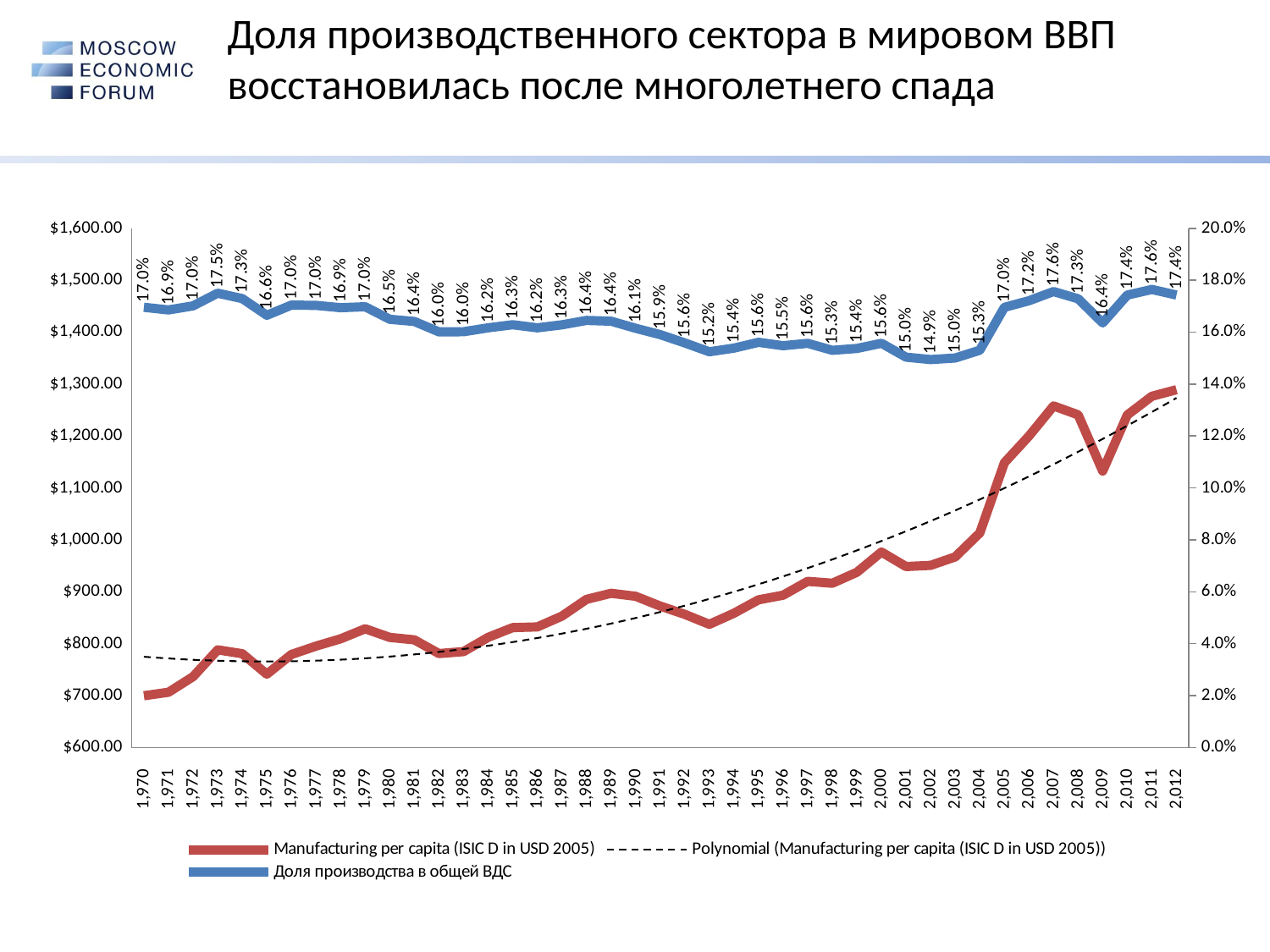
Which is larger, Доля производства в общей ВДС in 1973 or in 1975? 1973 Is the value of Manufacturing per capita in 2012 greater or less than $1,200.00? greater What is the value of Доля производства в общей ВДС in 1970? 17.0% Is the value of Manufacturing per capita in 1970 greater or less than $800.00? less What is the value of Доля производства в общей ВДС in 2002? 14.9% What is the difference between Доля производства в общей ВДС in 2012 and in 2002? 2.5 percentage points What kind of chart is shown on the slide? line chart What is the value of Доля производства в общей ВДС in 2012? 17.4% How many entries does the legend list? 3 How many years are plotted on the x axis? 43 In which year is Доля производства в общей ВДС at its lowest? 2002 Does Manufacturing per capita generally rise or fall from 1970 to 2012? rise